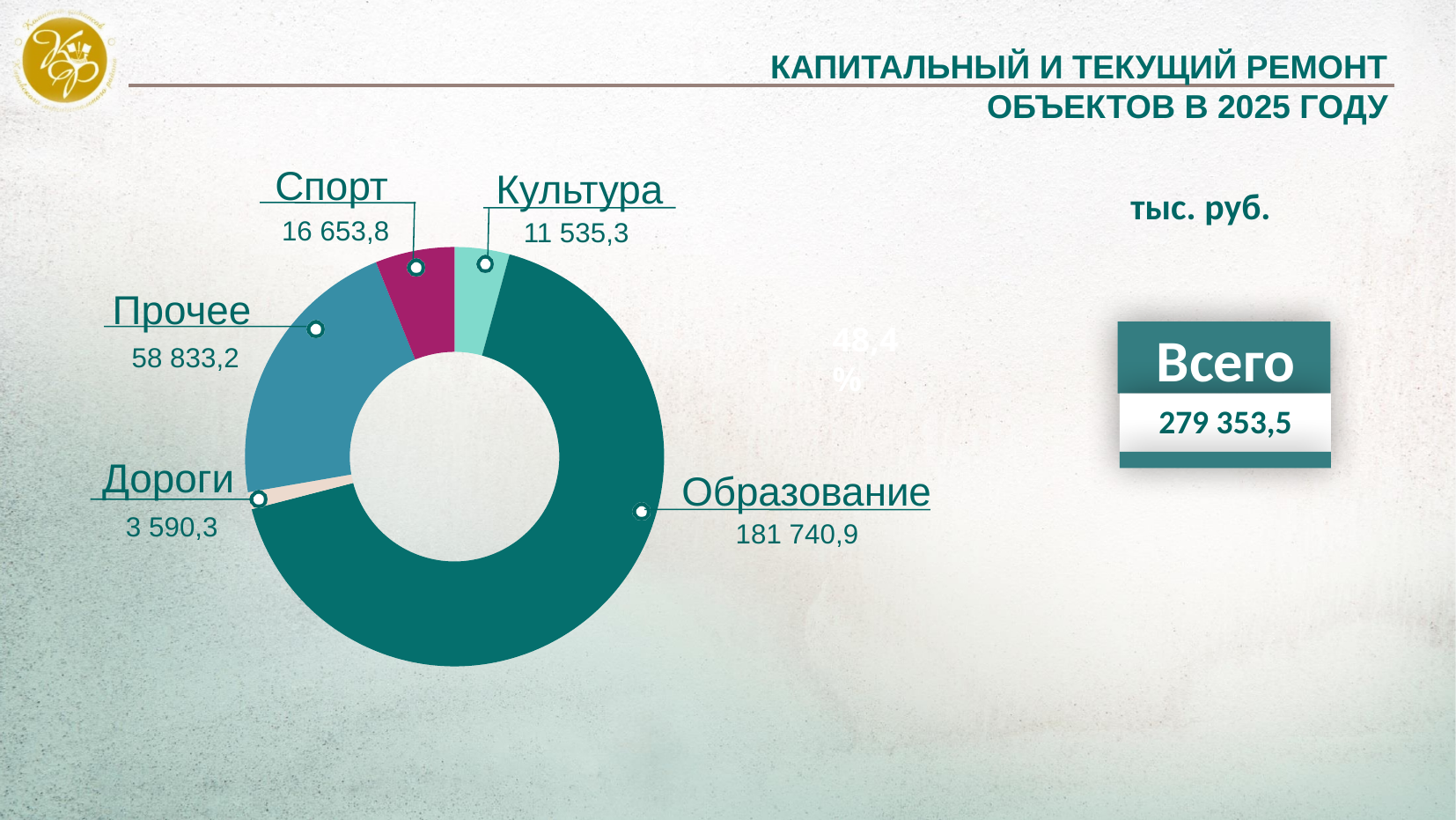
What is the value for Культура? 11 535,3 What is the difference between the values for Образование and Прочее? 122 907,7 What is the value for Спорт? 16 653,8 Which category has the smallest value? Дороги How many categories are shown in the chart? 5 What is the value for Прочее? 58 833,2 What is the value for Образование? 181 740,9 What total value is shown in the 'Всего' box next to the chart? 279 353,5 Which is larger, Спорт or Культура? Спорт What is the value for Дороги? 3 590,3 Which category has the largest value? Образование What kind of chart is shown on the slide? Doughnut chart